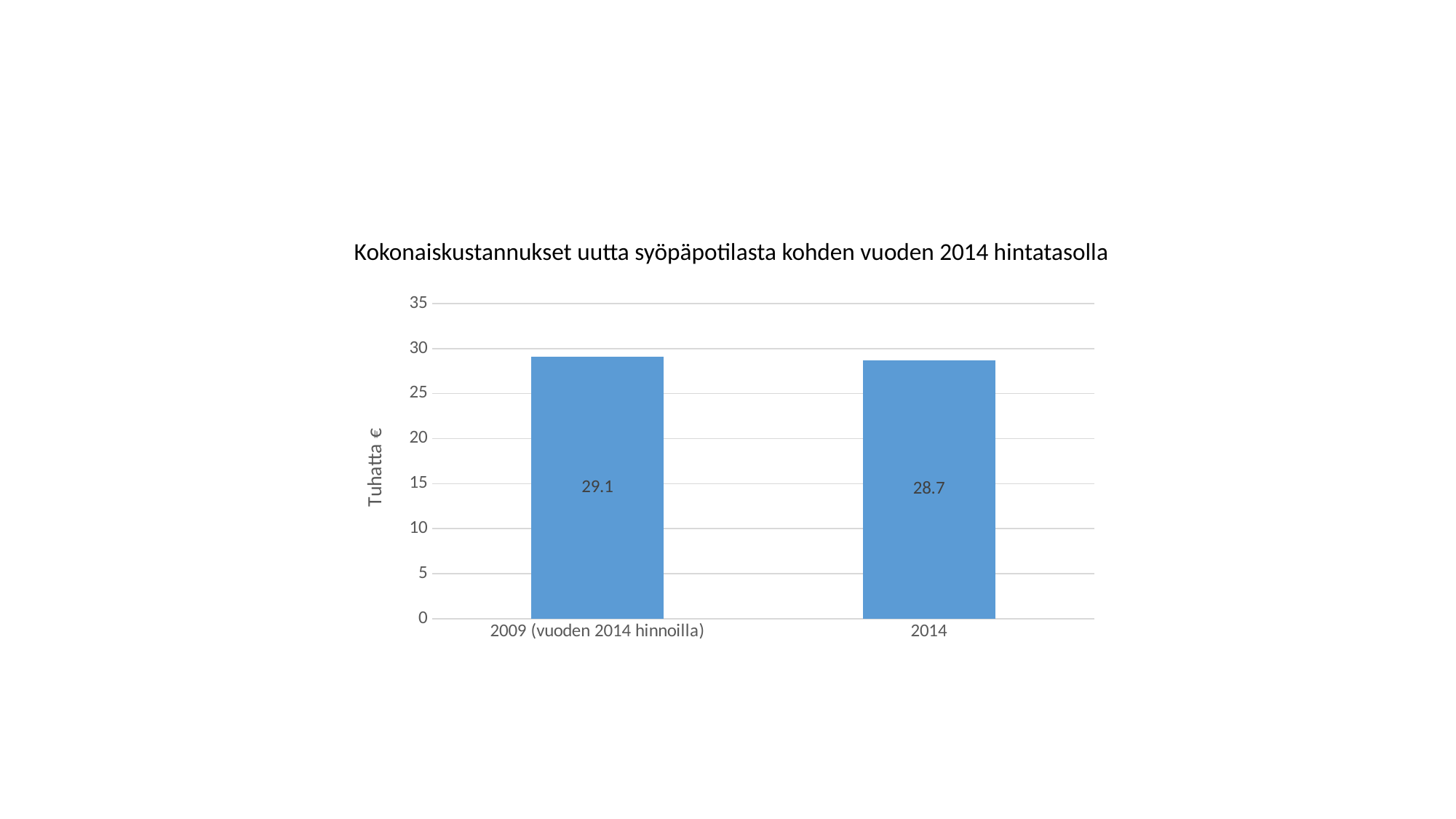
Do the values rise or fall from 2009 (vuoden 2014 hinnoilla) to 2014? fall Which category has the highest value? 2009 (vuoden 2014 hinnoilla) Which is larger, the value for 2009 (vuoden 2014 hinnoilla) or the value for 2014? 2009 (vuoden 2014 hinnoilla) Which category has the lowest value? 2014 What is the difference between the values for 2009 (vuoden 2014 hinnoilla) and 2014? 0.4 What is the label of the y axis? Tuhatta € What is the value for 2009 (vuoden 2014 hinnoilla)? 29.1 What is the value for 2014? 28.7 Is the value for 2014 greater or less than 30? less What kind of chart is shown on the slide? bar chart How many categories are shown on the x axis? 2 Is the value for 2009 (vuoden 2014 hinnoilla) greater or less than 25? greater